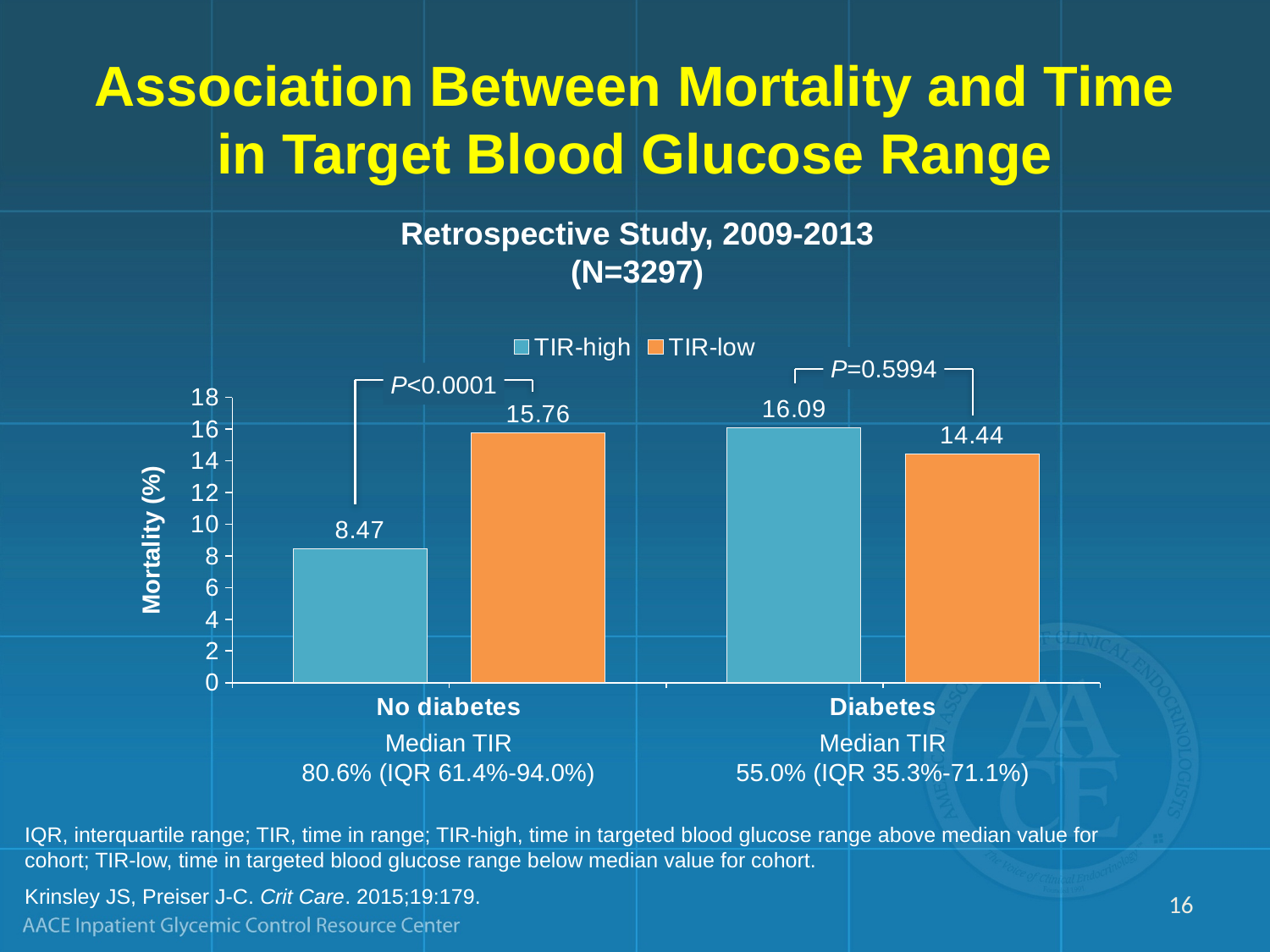
How many patient groups are shown on the x axis? 2 What kind of chart is shown on the slide? Bar chart Which bar shows the highest mortality on the chart? TIR-high, Diabetes (16.09) Which bar shows the lowest mortality on the chart? TIR-high, No diabetes (8.47) How many series does the legend list? 2 What is the mortality (%) for TIR-low in the Diabetes group? 14.44 What is the mortality (%) for TIR-low in the No diabetes group? 15.76 What is the P value shown for the No diabetes comparison? P<0.0001 What is the mortality (%) for TIR-high in the No diabetes group? 8.47 Is the mortality for TIR-high in the No diabetes group greater or less than 10? less In the Diabetes group, which has higher mortality, TIR-high or TIR-low? TIR-high What is the difference in mortality (%) between TIR-low and TIR-high in the No diabetes group? 7.29